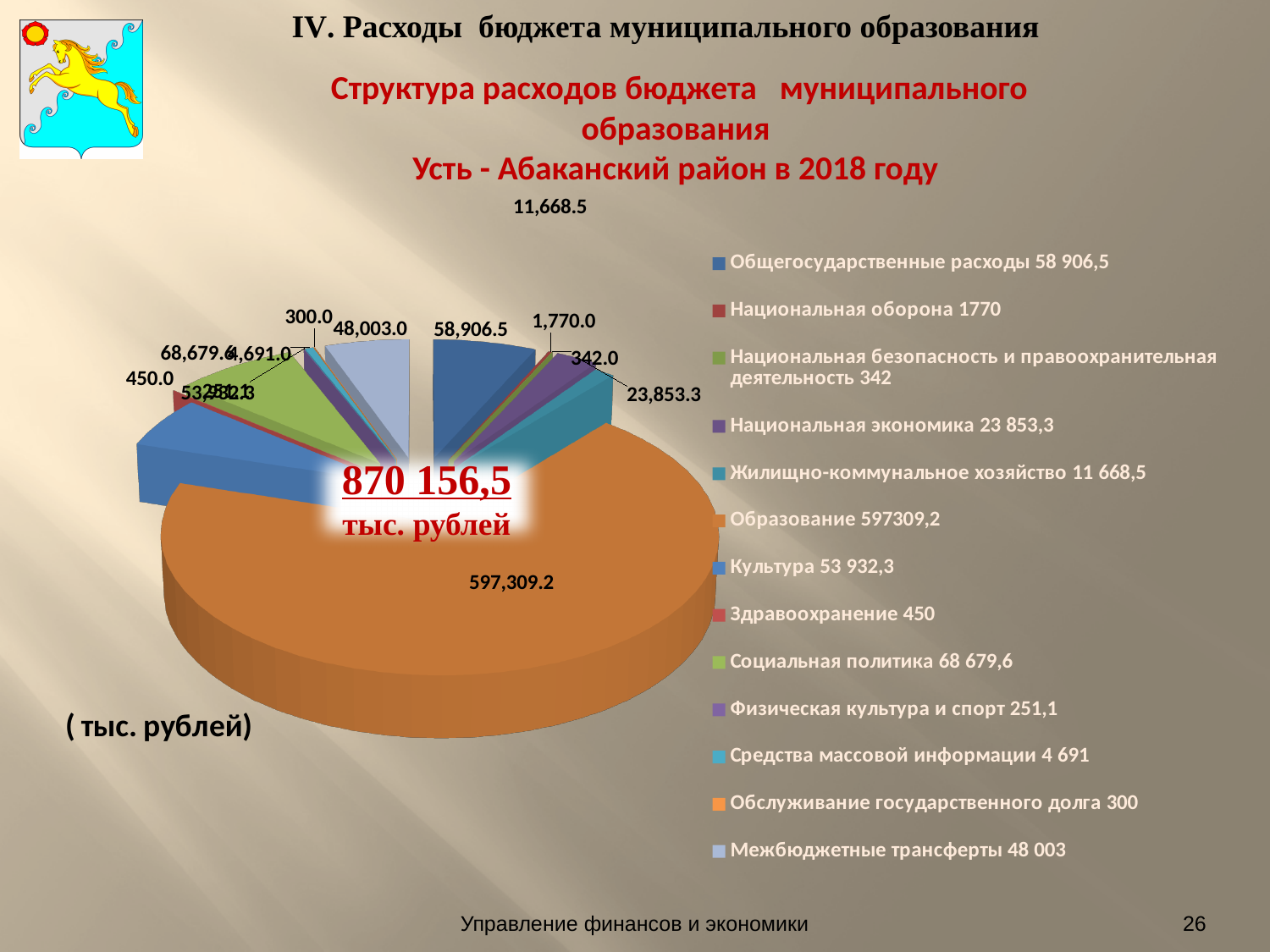
What is the value for Культура according to the legend? 53 932,3 Which category has the largest slice of the pie? Образование What total amount is printed in the centre of the pie chart? 870 156,5 тыс. рублей Which is larger, Национальная экономика or Жилищно-коммунальное хозяйство? Национальная экономика Which category has the smallest value in the pie chart? Физическая культура и спорт What kind of chart is shown on the slide? pie chart What is the value for Межбюджетные трансферты? 48,003.0 What is the difference between Общегосударственные расходы (58,906.5) and Межбюджетные трансферты (48,003.0)? 10,903.5 What is the value for Национальная экономика? 23,853.3 What is the value for Образование? 597,309.2 What is the value for Общегосударственные расходы? 58,906.5 How many categories does the pie chart's legend list? 13